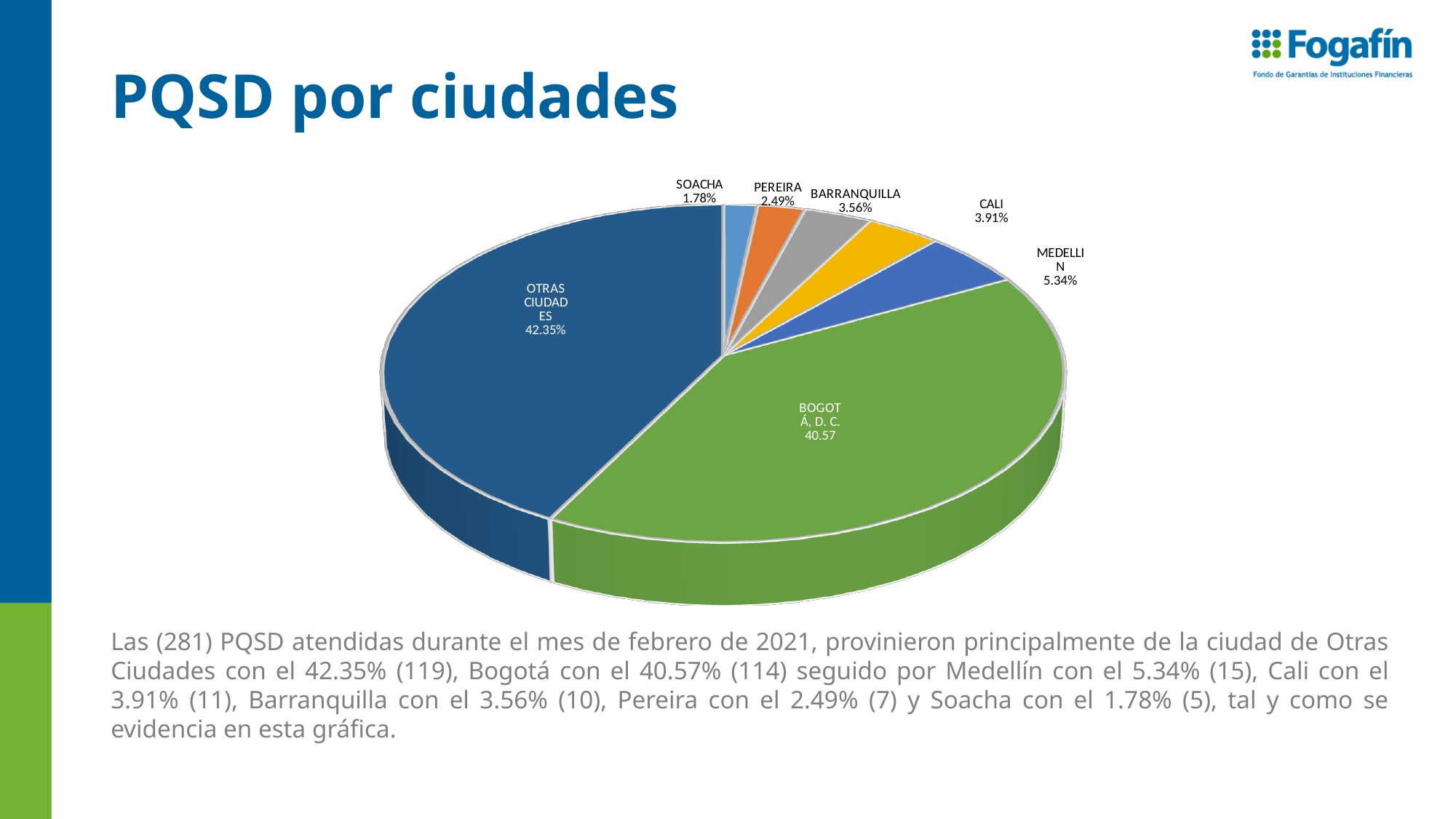
What percentage does the pie chart show for Soacha? 1.78% What type of chart is shown on the slide? Pie chart What percentage does the pie chart show for Cali? 3.91% What percentage does the pie chart show for Medellín? 5.34% How many slices does the pie chart have? 7 Which category has the largest slice in the pie chart? Otras Ciudades What value is printed on the Bogotá, D. C. slice of the pie chart? 40.57 What is the title of the slide containing the pie chart? PQSD por ciudades What percentage does the pie chart show for Barranquilla? 3.56% Which city has the smallest slice in the pie chart? Soacha What percentage does the pie chart show for Otras Ciudades? 42.35% What is the difference in percentage points between Medellín and Pereira in the pie chart? 2.85